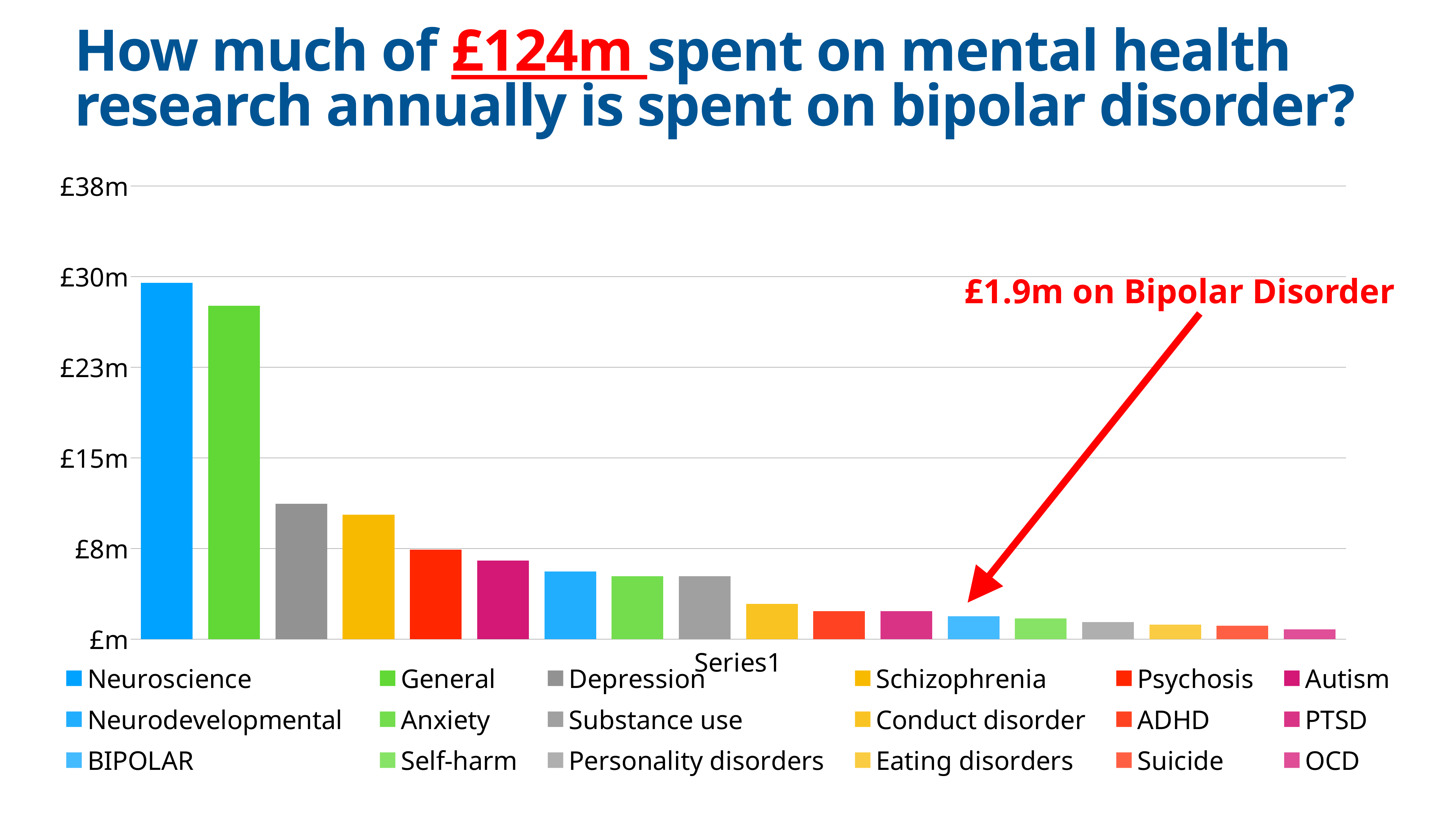
What kind of chart is shown on the slide? bar chart Do the bar values rise or fall from left to right across the chart? fall Which category has the lowest bar in the chart? OCD Is the value for Depression greater or less than £8m? greater Is the value for Neuroscience greater or less than £23m? greater How much is spent on bipolar disorder according to the annotation on the chart? £1.9m Which is larger, the value for Depression or the value for Schizophrenia? Depression Is the value for General greater or less than £30m? less How many categories are plotted in the chart? 18 Which is larger, the value for Neuroscience or the value for General? Neuroscience Which category has the highest bar in the chart? Neuroscience